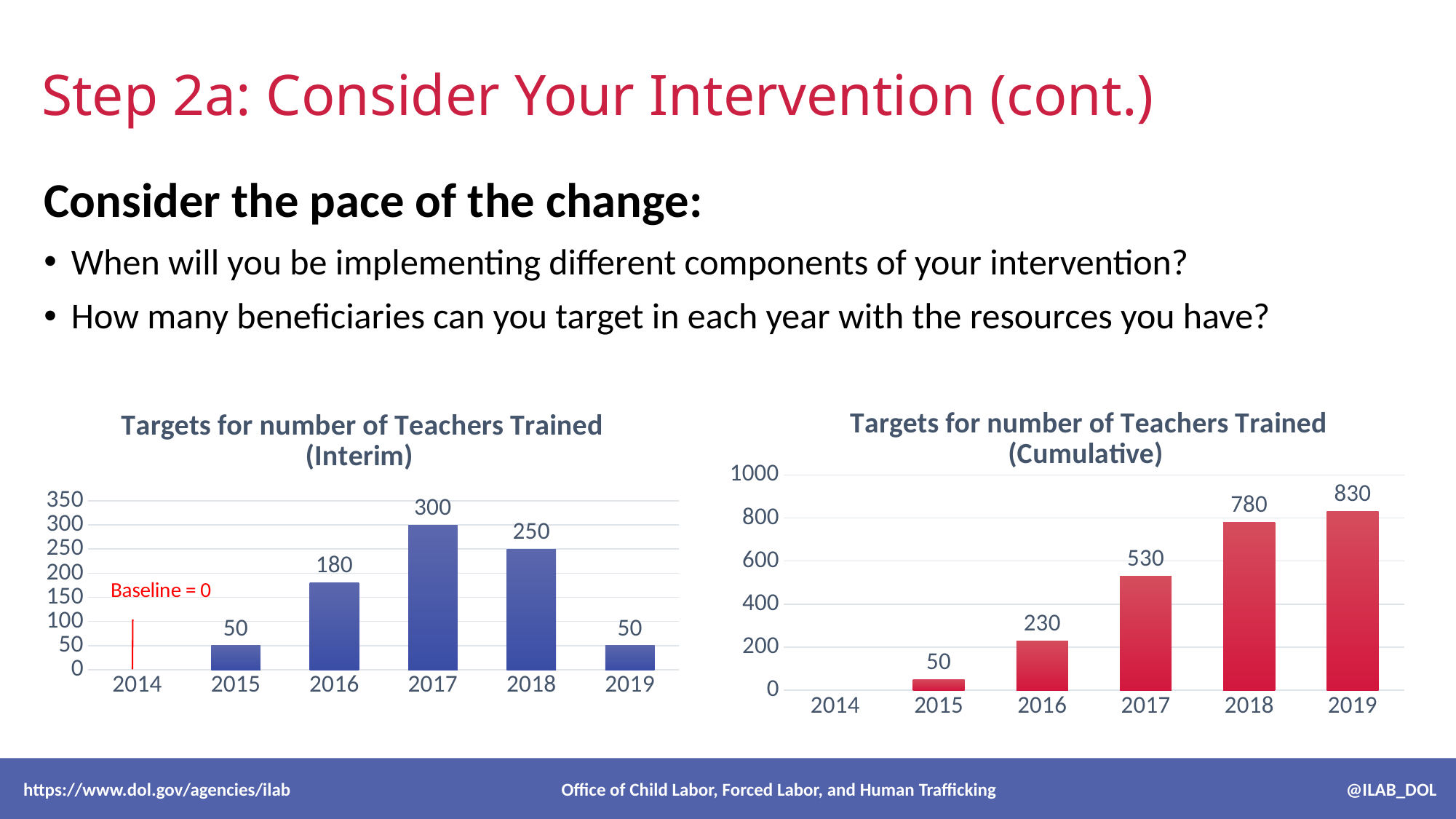
In the 'Targets for number of Teachers Trained (Interim)' chart, what is the difference between the values for 2017 and 2018? 50 In the 'Targets for number of Teachers Trained (Interim)' chart, what is the value for 2017? 300 In the 'Targets for number of Teachers Trained (Interim)' chart, which year has the highest value? 2017 What kind of chart is the 'Targets for number of Teachers Trained (Cumulative)' chart? bar chart In the 'Targets for number of Teachers Trained (Interim)' chart, which is larger, the value for 2016 or the value for 2018? 2018 In the 'Targets for number of Teachers Trained (Cumulative)' chart, do the values rise or fall from 2015 to 2019? rise In the 'Targets for number of Teachers Trained (Cumulative)' chart, what is the value for 2018? 780 In the 'Targets for number of Teachers Trained (Interim)' chart, what is the baseline value shown for 2014? 0 In the 'Targets for number of Teachers Trained (Cumulative)' chart, what is the value for 2016? 230 In the 'Targets for number of Teachers Trained (Cumulative)' chart, what is the difference between the values for 2019 and 2017? 300 In the 'Targets for number of Teachers Trained (Cumulative)' chart, which year has the highest value? 2019 In the 'Targets for number of Teachers Trained (Interim)' chart, what is the value for 2016? 180